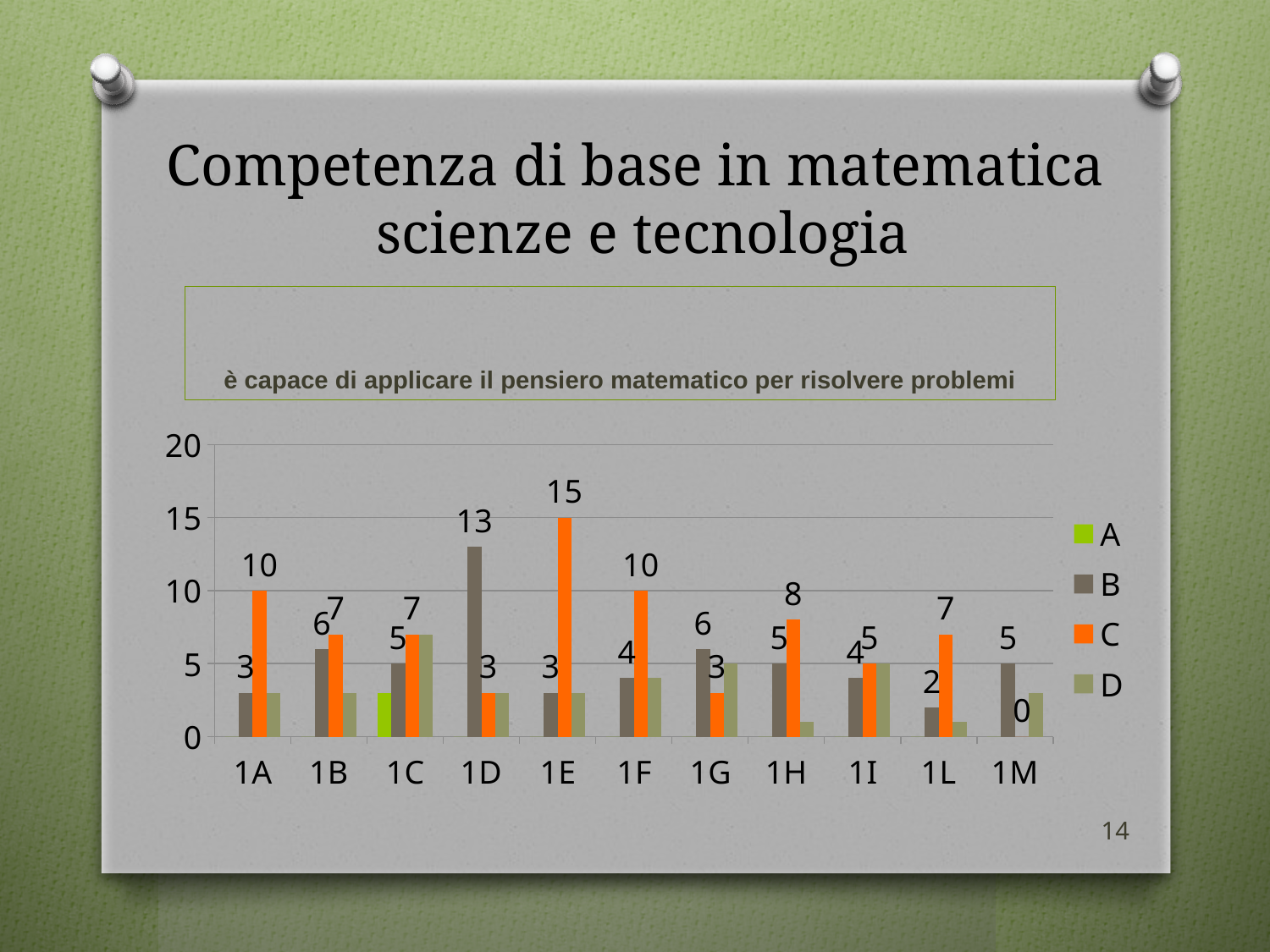
What is the difference between series C and series B for class 1E? 12 Is the value of series D for class 1H greater or less than 5? less What kind of chart is shown on the slide? bar chart What is the value of series B for class 1L? 2 How many series does the legend list? 4 How many categories (classes) are shown on the x axis? 11 Which class has the highest value for series C? 1E Which class has the highest value for series B? 1D What is the value of series C for class 1E? 15 Which colour represents series C in the legend? orange For class 1A, which is larger: series B or series C? C What is the value of series B for class 1D? 13